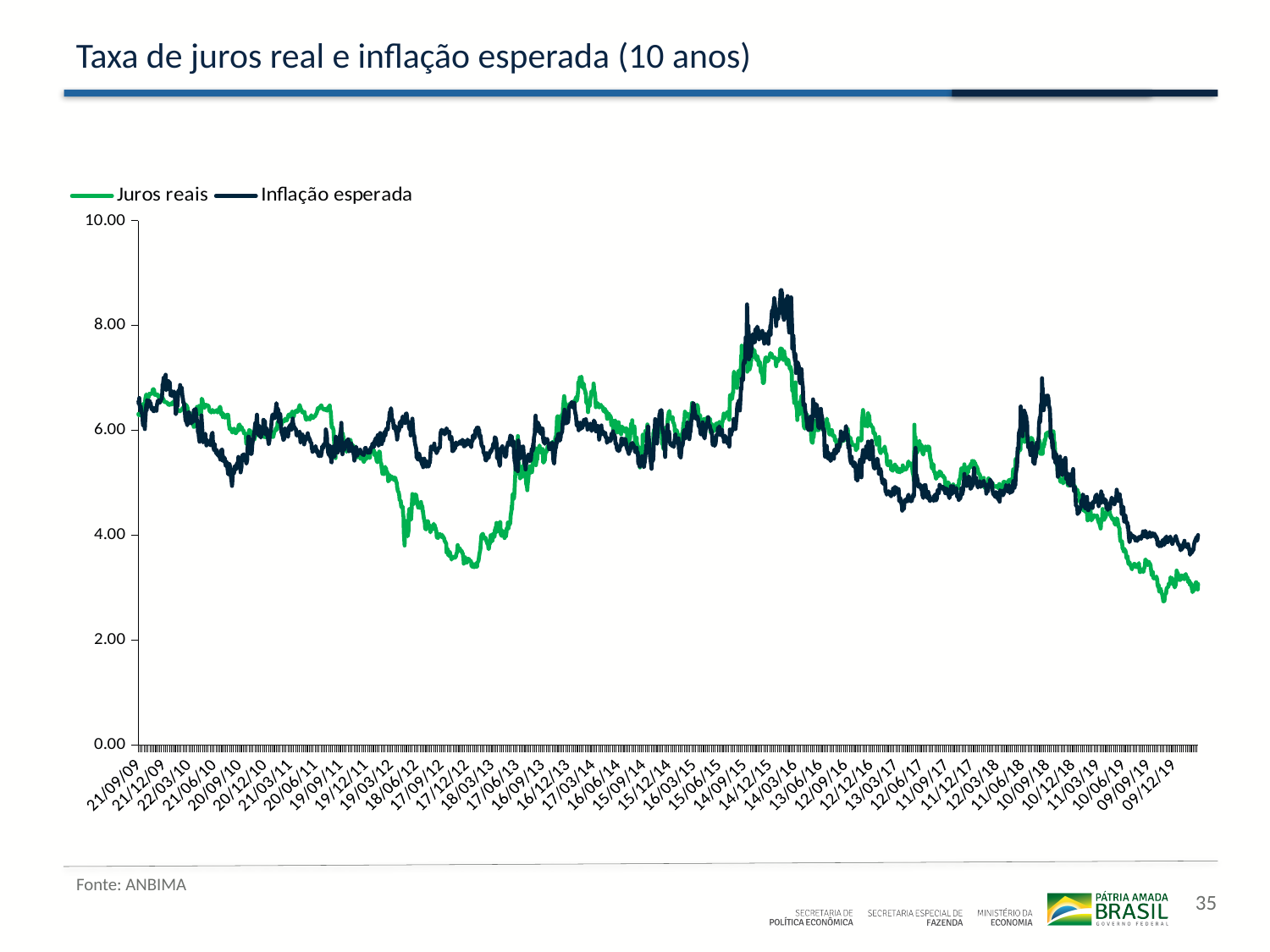
How many series does the legend list? 2 What is the title of the chart? Taxa de juros real e inflação esperada (10 anos) Is the highest value reached by Juros reais greater or less than 8.00? less Does Juros reais rise or fall from the start of the series to the end? Fall Which series is drawn in green? Juros reais Is the highest value reached by Inflação esperada greater or less than 8.00? greater What kind of chart is shown on the slide? Line chart Which series reaches the highest peak on the chart? Inflação esperada Around 17/12/12, which series has the higher value: Juros reais or Inflação esperada? Inflação esperada Is the value of Juros reais at the end of the series (09/12/19) greater or less than 4.00? less At the end of the series (09/12/19), which is higher: Juros reais or Inflação esperada? Inflação esperada